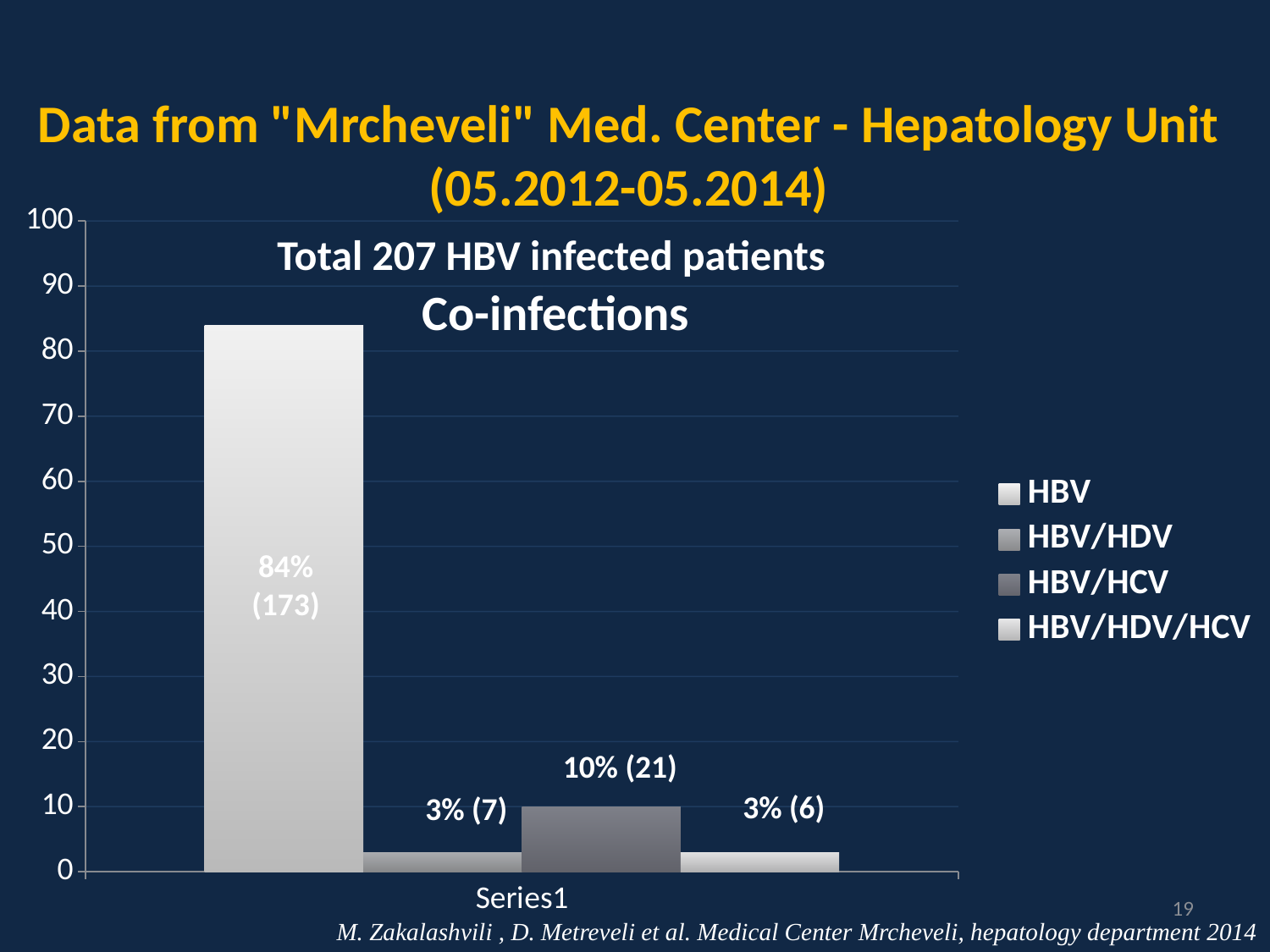
Which series has the fewest patients according to the data labels? HBV/HDV/HCV Which is larger, the value for HBV/HCV or the value for HBV/HDV? HBV/HCV What is the total number of HBV infected patients stated on the chart? 207 How many series does the legend list? 4 Which series has the highest value in the chart? HBV Is the value for HBV greater or less than 80? greater What is the data label shown for HBV/HDV? 3% (7) What is the data label shown for HBV/HDV/HCV? 3% (6) What is the data label shown on the HBV bar? 84% (173) What kind of chart is shown on the slide? bar chart How many more patients are in the HBV group than in the HBV/HCV group? 152 What is the data label shown for HBV/HCV? 10% (21)